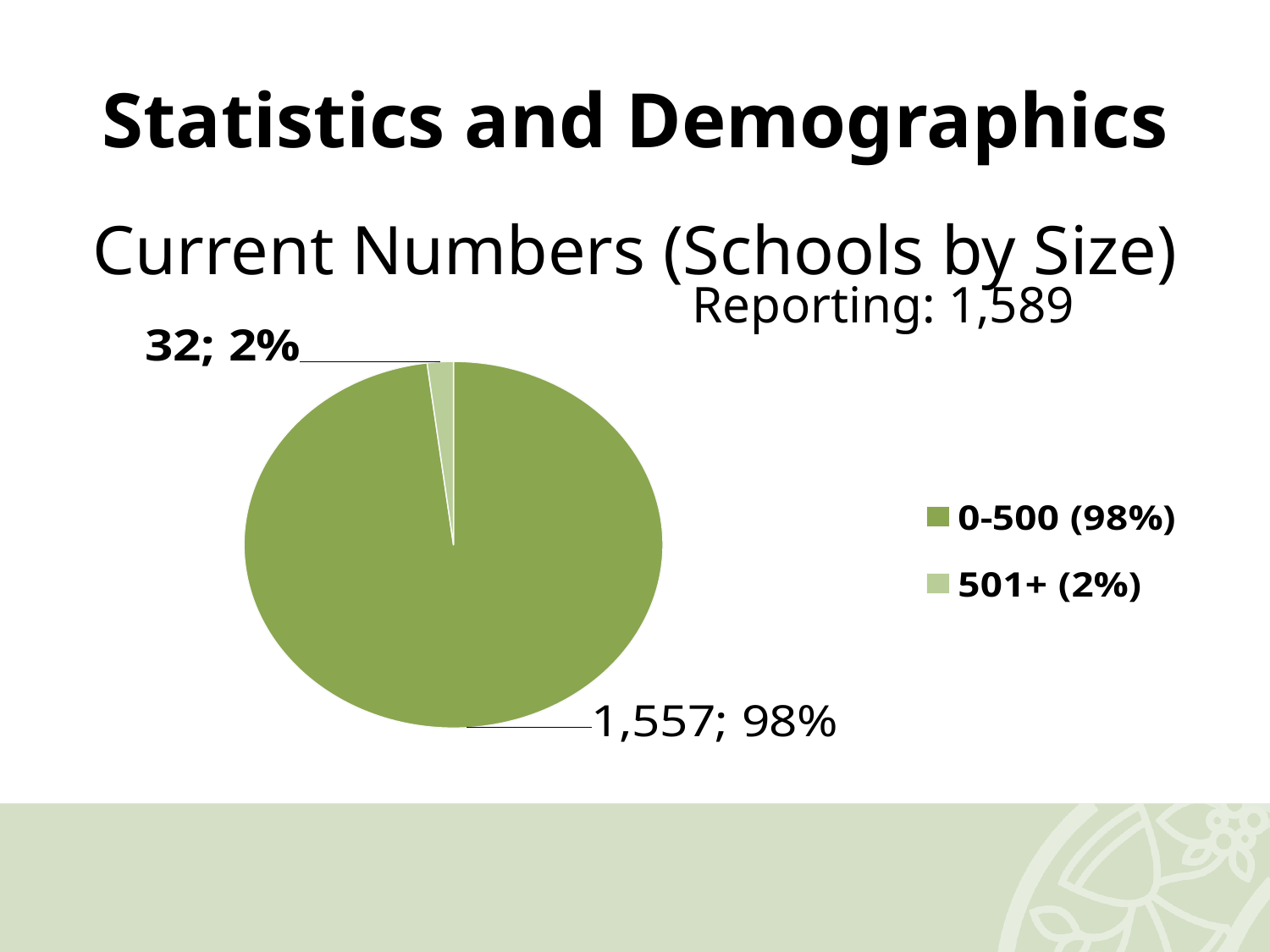
What share of the pie does the 501+ category represent? 2% How many categories does the pie chart show? 2 How many schools are in the 501+ size category? 32 What kind of chart is shown on the slide? pie chart How many schools are in the 0-500 size category? 1,557 What is the title of the chart? Current Numbers (Schools by Size) Which category has more schools, 0-500 or 501+? 0-500 Which category has the largest slice of the pie? 0-500 Which category has the smallest slice of the pie? 501+ What is the difference between the number of schools in the 0-500 category and the 501+ category? 1,525 What share of the pie does the 0-500 category represent? 98% What is the total number of schools reporting, as stated on the slide? 1,589